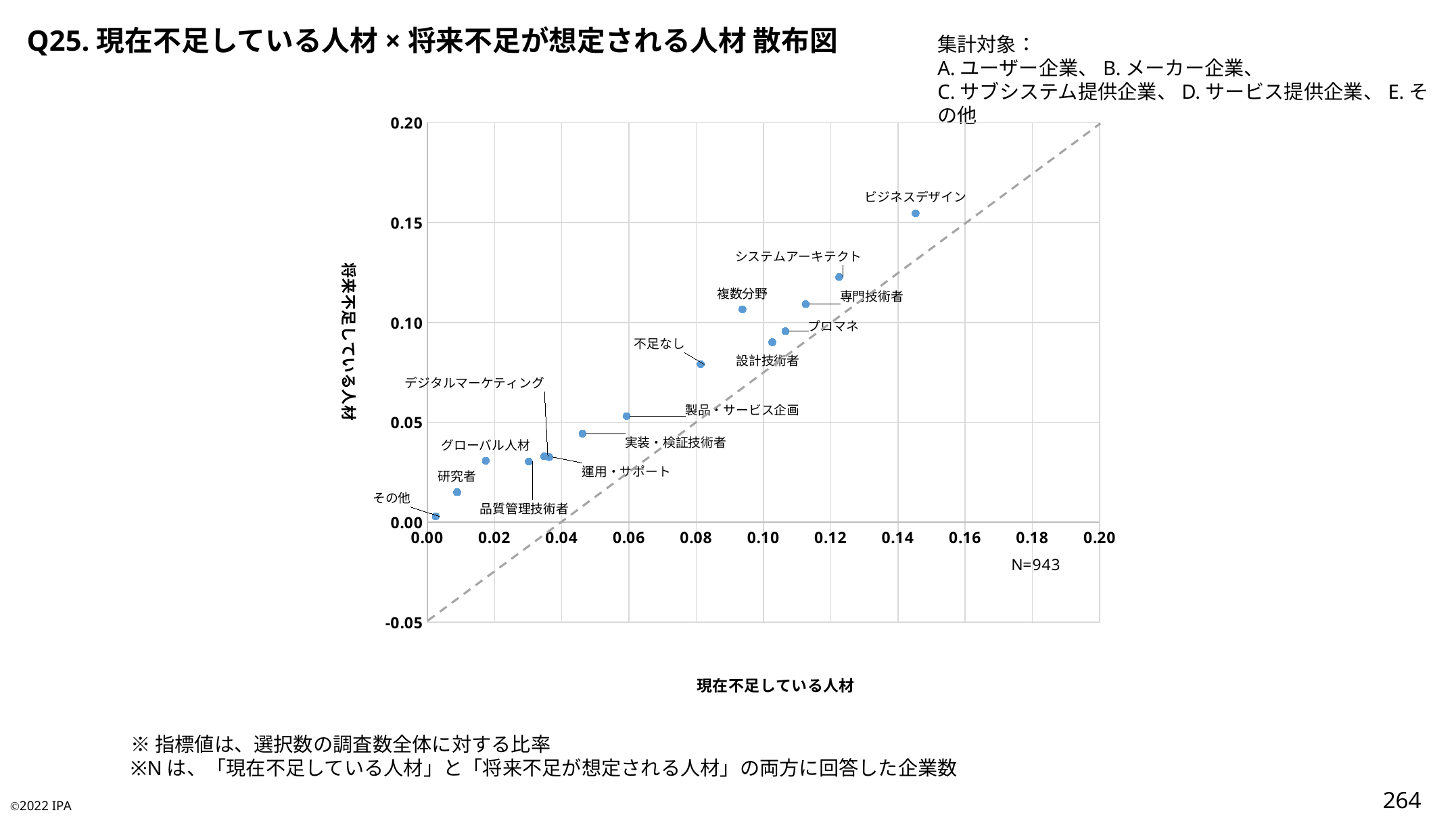
Which data point has the highest value on the vertical axis (将来不足が想定される人材)? ビジネスデザイン Is the vertical-axis value for 不足なし greater or less than 0.10? less Is the horizontal-axis value for ビジネスデザイン greater or less than 0.12? greater What is the N value shown below the chart? N=943 Is the vertical-axis value for システムアーキテクト greater or less than 0.10? greater Do the vertical-axis values generally rise or fall as the horizontal-axis values increase? rise How many labelled data points are plotted in the scatter chart? 15 What kind of chart is shown on the slide? Scatter chart Which data point has the lowest value on the horizontal axis (現在不足している人材)? その他 Which has the larger horizontal-axis value, 製品・サービス企画 or 実装・検証技術者? 製品・サービス企画